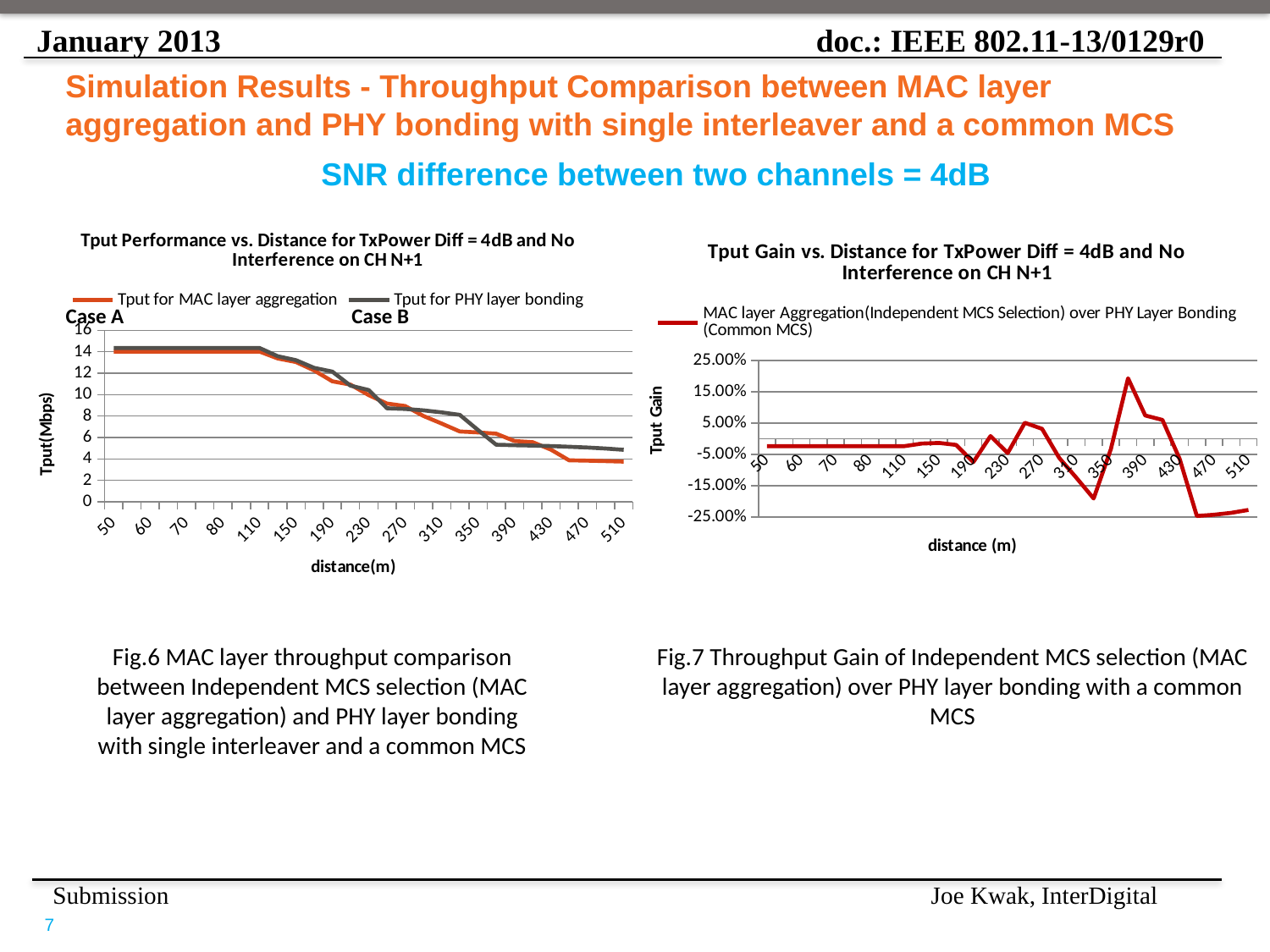
In the left chart, 'Tput Performance vs. Distance', is the value for Tput for PHY layer bonding at distance 510 greater or less than 8? less In the left chart, 'Tput Performance vs. Distance', is the value for Tput for MAC layer aggregation at distance 50 greater or less than 12? greater What is the y-axis title of the left chart, 'Tput Performance vs. Distance'? Tput(Mbps) What kind of chart is the left chart, 'Tput Performance vs. Distance for TxPower Diff = 4dB and No Interference on CH N+1'? line chart In the left chart, 'Tput Performance vs. Distance', which series has the higher value at distance 510? Tput for PHY layer bonding In the right chart, 'Tput Gain vs. Distance', is the Tput Gain at distance 470 greater or less than -15.00%? less How many series does the legend of the left chart, 'Tput Performance vs. Distance', list? 2 In the left chart, 'Tput Performance vs. Distance', do the throughput values rise or fall as distance increases? fall How many series does the legend of the right chart, 'Tput Gain vs. Distance', list? 1